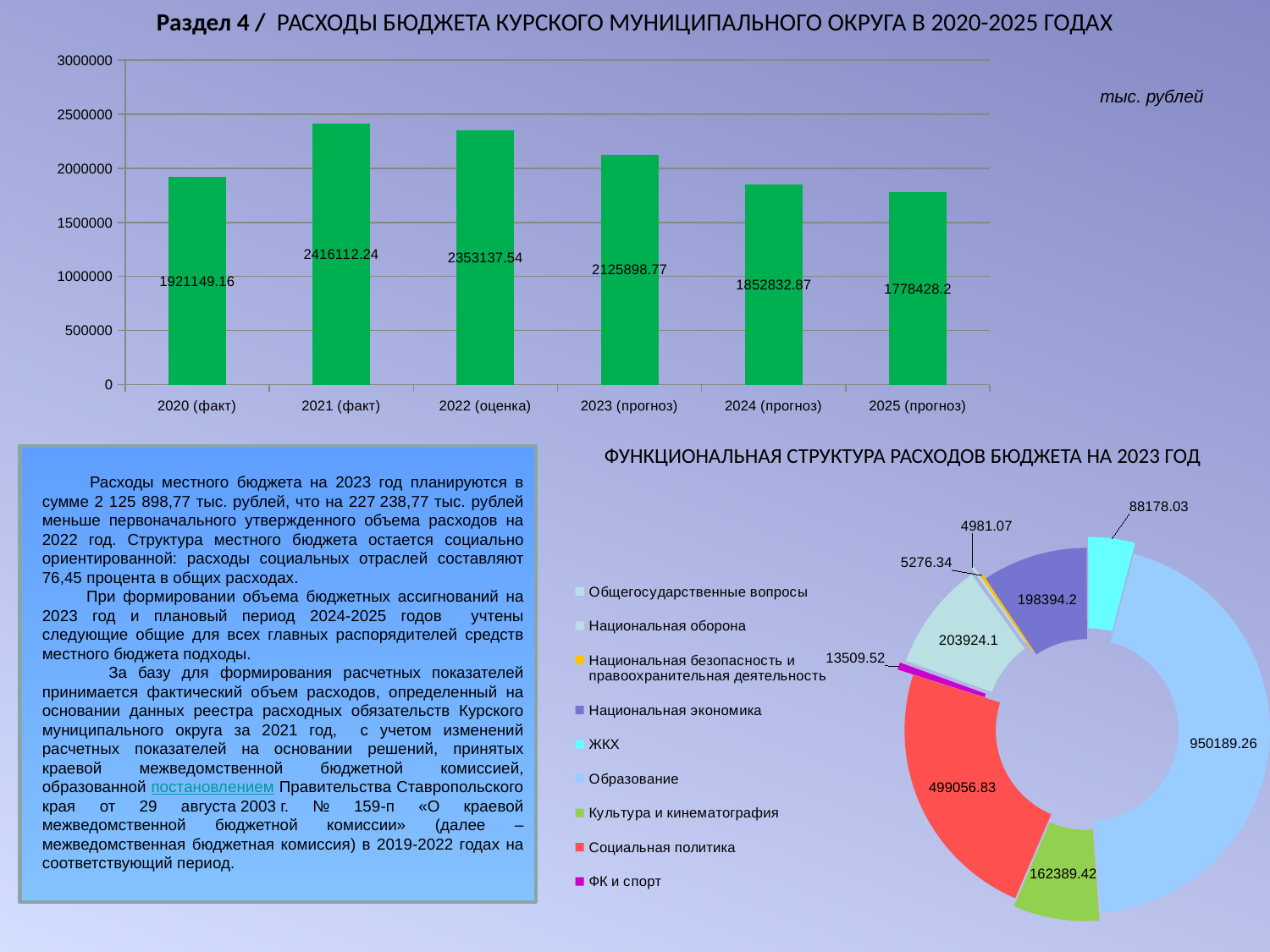
In the top bar chart, which year has the lowest value? 2025 (прогноз) In the doughnut chart 'ФУНКЦИОНАЛЬНАЯ СТРУКТУРА РАСХОДОВ БЮДЖЕТА НА 2023 ГОД', what is the value for Социальная политика? 499056.83 In the top bar chart, what is the value for 2023 (прогноз)? 2125898.77 In the top bar chart, which year has the highest value? 2021 (факт) How many bars are in the top bar chart? 6 In the top bar chart, do the values rise or fall from 2021 (факт) to 2025 (прогноз)? fall In the top bar chart, what is the difference between the values for 2022 (оценка) and 2023 (прогноз)? 227238.77 How many entries does the legend of the doughnut chart 'ФУНКЦИОНАЛЬНАЯ СТРУКТУРА РАСХОДОВ БЮДЖЕТА НА 2023 ГОД' list? 9 In the doughnut chart 'ФУНКЦИОНАЛЬНАЯ СТРУКТУРА РАСХОДОВ БЮДЖЕТА НА 2023 ГОД', what is the value for Образование? 950189.26 What kind of chart is the top chart on the slide? bar chart In the top bar chart, is the value for 2024 (прогноз) greater or less than 2000000? less In the top bar chart, which is larger: the value for 2020 (факт) or 2024 (прогноз)? 2020 (факт)